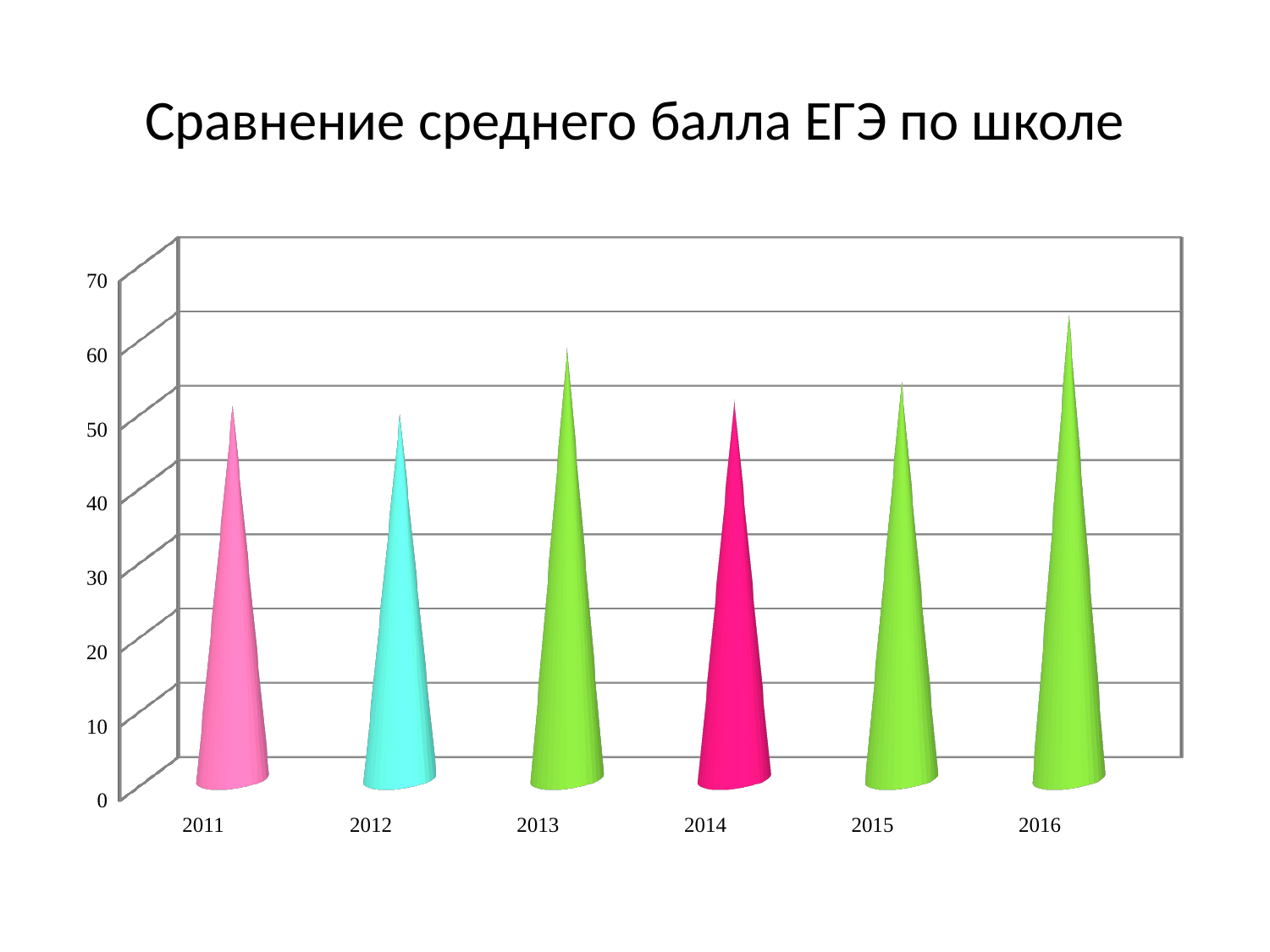
What kind of chart is shown on the slide? bar chart Is the value for 2016 greater or less than 50? greater What is the title of the chart? Сравнение среднего балла ЕГЭ по школе Which is larger, the value for 2016 or the value for 2015? 2016 Which year has the highest average score in the chart? 2016 Is the value for 2014 greater or less than 60? less How many years are shown on the x axis of the chart? 6 Is the value for 2011 greater or less than 60? less Which is larger, the value for 2013 or the value for 2014? 2013 What colour is the bar for 2012? cyan